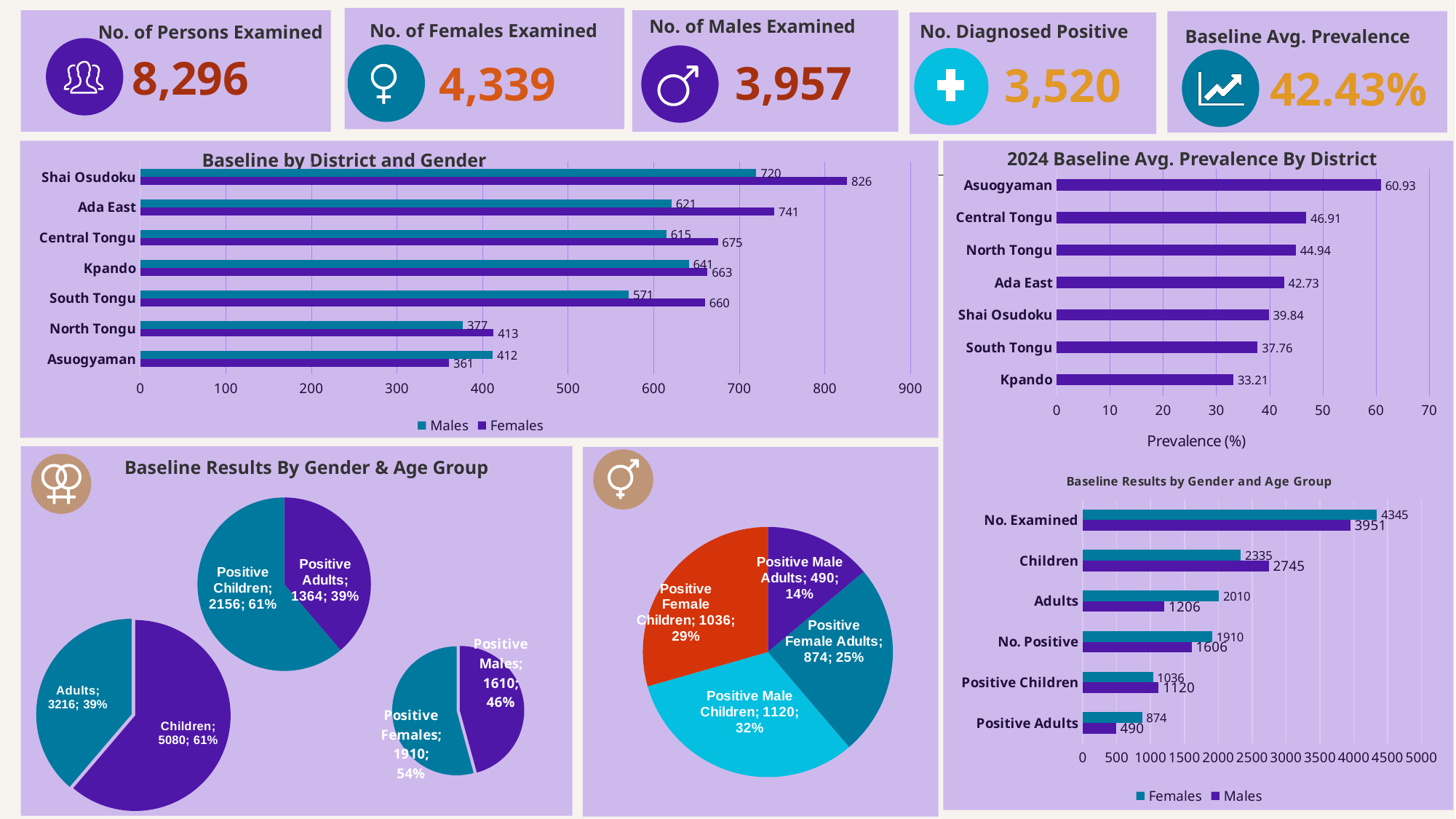
In the 'Baseline by District and Gender' chart, how many series does the legend list? 2 In the 'Baseline Results by Gender and Age Group' bar chart (bottom right), what is the value for Males in Positive Adults? 490 In the 'Baseline Results by Gender and Age Group' bar chart (bottom right), which is larger for Adults: Females or Males? Females In the 'Baseline by District and Gender' chart, which district has the lowest value for Males? North Tongu In the 'Baseline by District and Gender' chart, what is the value for Females in Shai Osudoku? 826 In the '2024 Baseline Avg. Prevalence By District' chart, which district has the highest prevalence? Asuogyaman In the 'Baseline Results By Gender & Age Group' pie charts, what share of the pie is Positive Females? 54% In the '2024 Baseline Avg. Prevalence By District' chart, how many districts are shown? 7 In the pie chart with the male symbol (bottom middle), what is the value for Positive Male Children? 1120; 32% What kind of chart is '2024 Baseline Avg. Prevalence By District'? bar chart In the 'Baseline by District and Gender' chart, what is the difference between Females and Males in Ada East? 120 In the '2024 Baseline Avg. Prevalence By District' chart, what is the prevalence for Kpando? 33.21